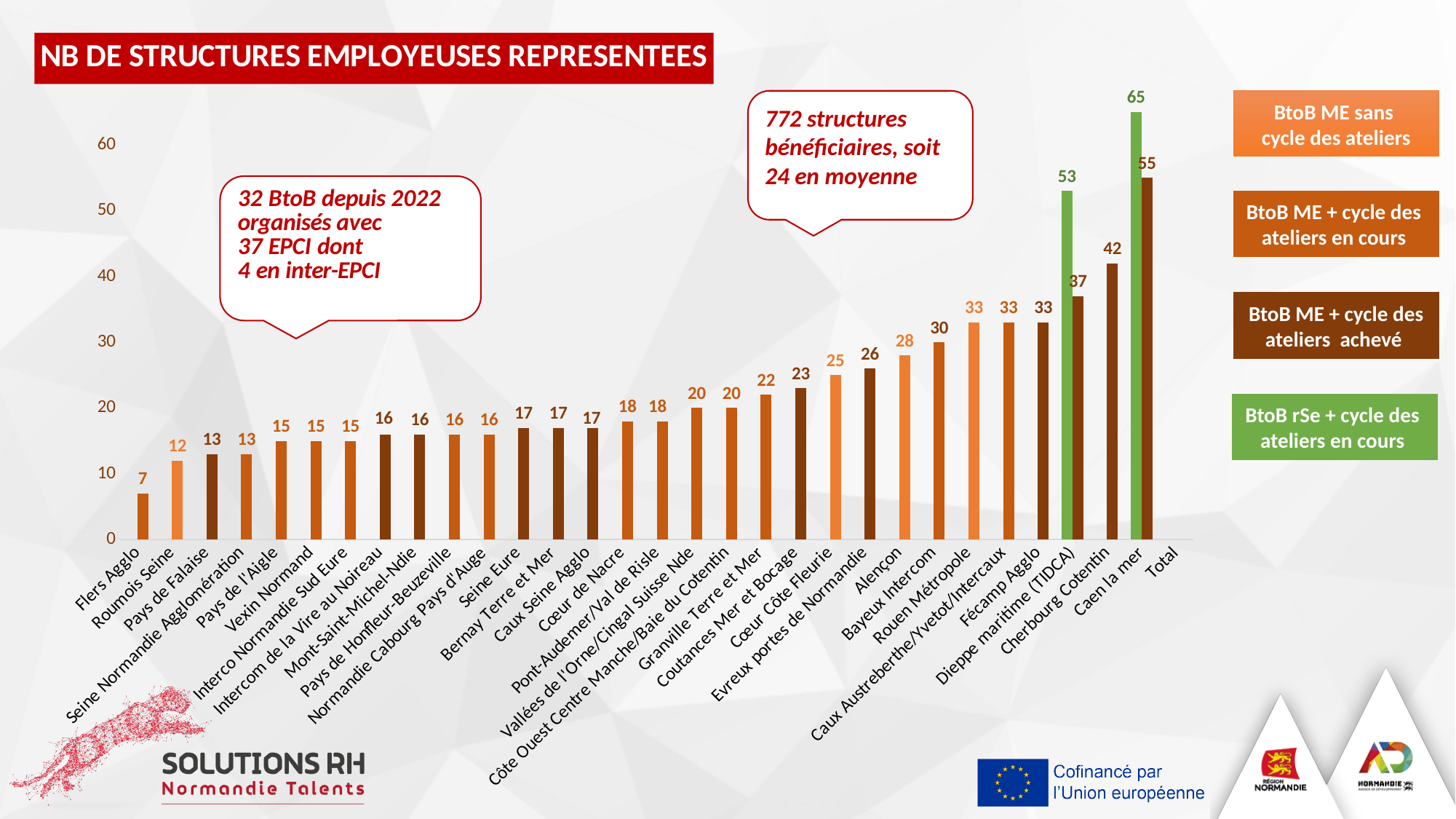
Which category has the tallest bar? Caen la mer Which is larger, the value for Alençon or the value for Bayeux Intercom? Bayeux Intercom What is the value for Granville Terre et Mer? 22 How many series does the legend list? 4 What is the value for Cherbourg Cotentin? 42 What type of chart is shown on the slide? bar chart Do the values generally rise or fall from left to right along the x axis? rise What is the difference between the values for Cherbourg Cotentin and Bayeux Intercom? 12 What is the value for Flers Agglo? 7 What is the value for Alençon? 28 Is the value for Cherbourg Cotentin greater or less than 40? greater Which category has the lowest value? Flers Agglo